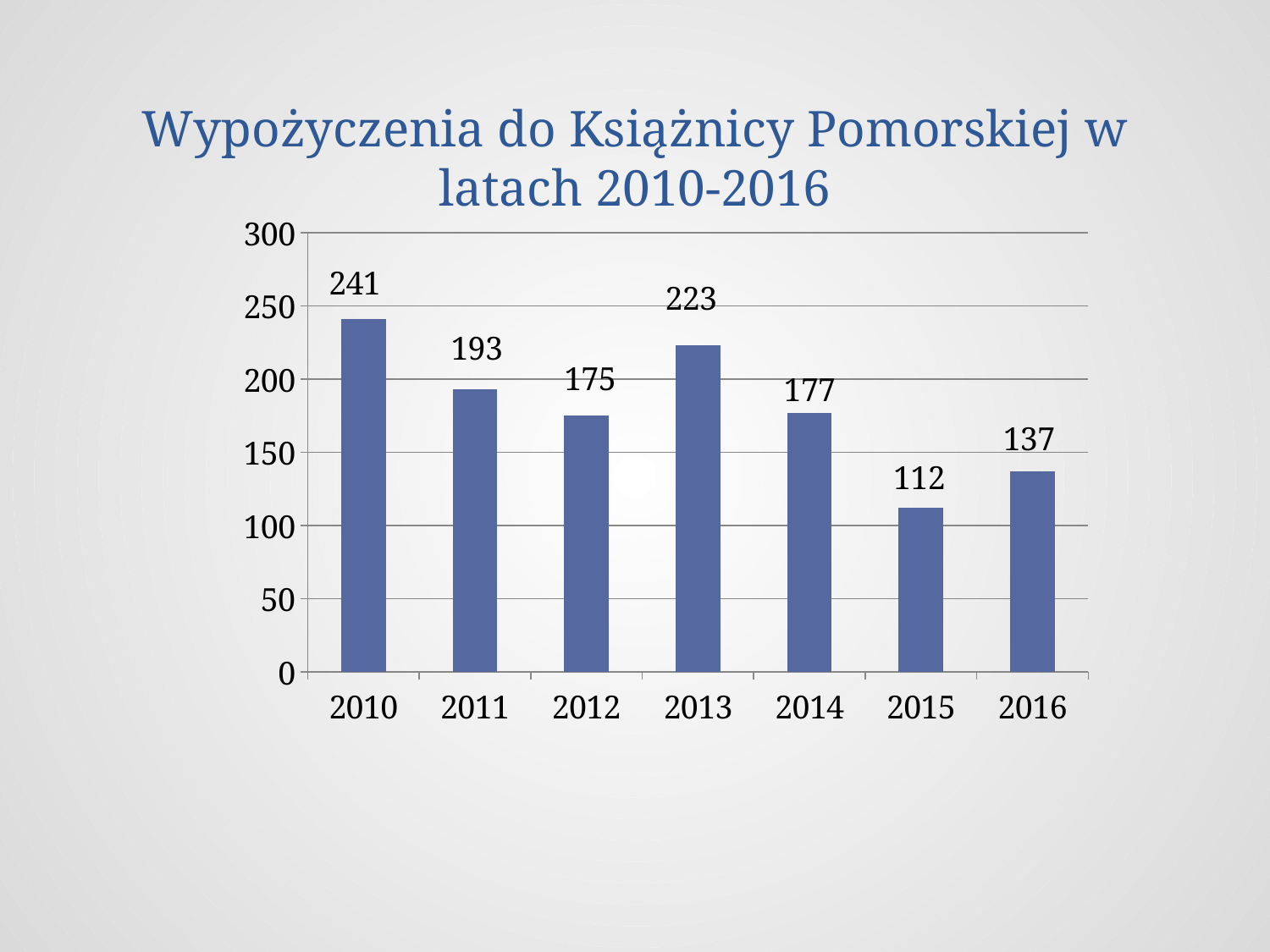
What is the difference between the values for 2013 and 2014? 46 What is the title of the chart? Wypożyczenia do Książnicy Pomorskiej w latach 2010-2016 What is the value for 2015? 112 How many years are shown on the x axis? 7 Is the value for 2014 greater or less than 150? greater What is the value for 2013? 223 What is the difference between the values for 2010 and 2016? 104 Which year has the highest value? 2010 What is the value for 2010? 241 What kind of chart is shown on the slide? bar chart Which is larger, the value for 2011 or the value for 2012? 2011 Which year has the lowest value? 2015